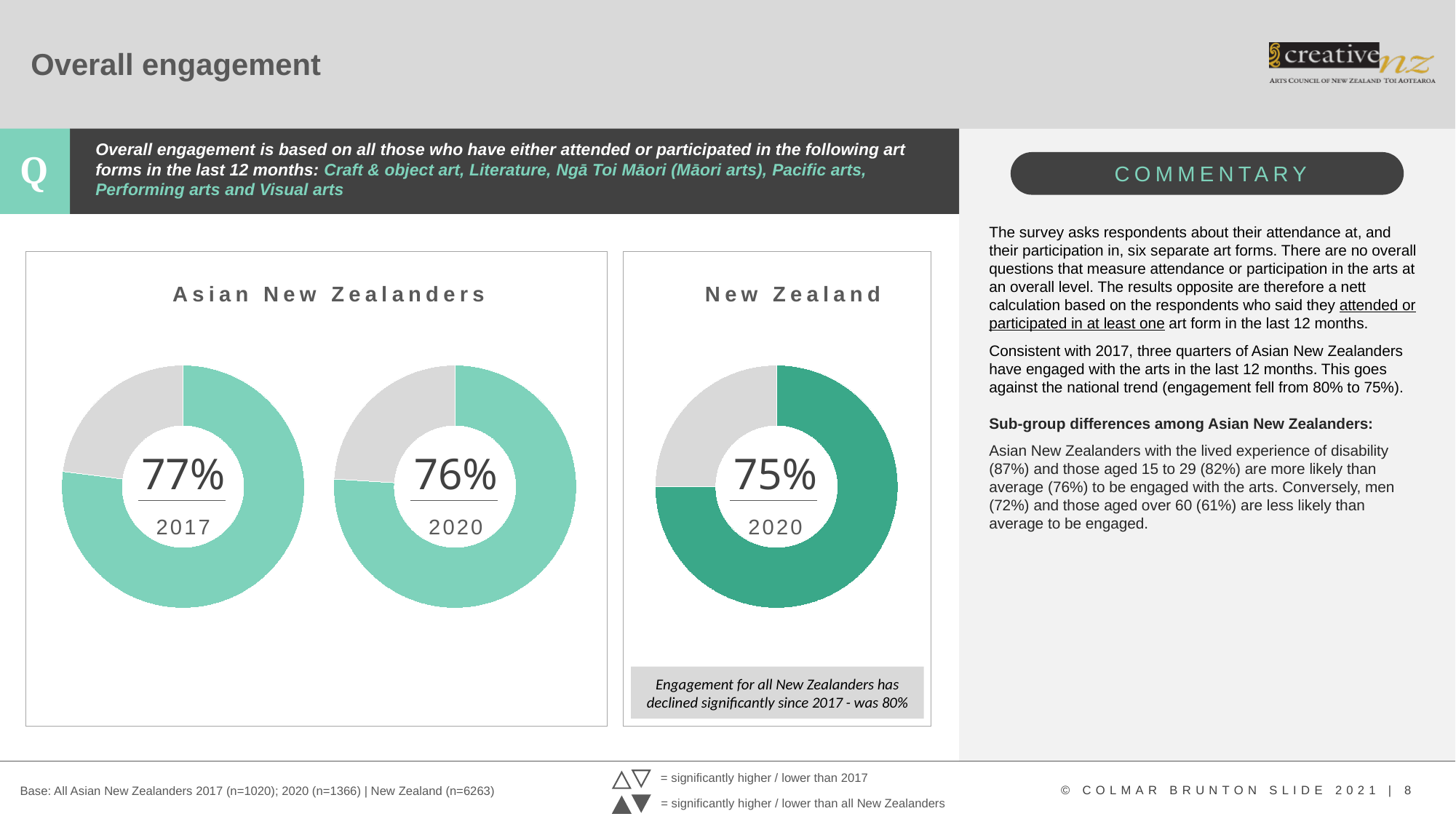
In the Asian New Zealanders chart, what is the overall engagement value shown for 2017? 77% How many donut charts are shown in the Asian New Zealanders panel? 2 In the New Zealand chart, what is the overall engagement value shown for 2020? 75% What kind of chart is used to show the engagement values on this slide? Donut (pie) chart According to the note under the New Zealand chart, what was engagement for all New Zealanders in 2017? 80% In the Asian New Zealanders chart, what is the overall engagement value shown for 2020? 76% Which is larger: the 2020 engagement for Asian New Zealanders or the 2020 engagement for New Zealand? Asian New Zealanders (76%) In the Asian New Zealanders chart, did engagement rise or fall from 2017 to 2020? Fall In the Asian New Zealanders chart, by how many percentage points did engagement change between 2017 and 2020? 1 percentage point In the New Zealand chart, by how many percentage points did engagement decline from 2017 (as stated in the note) to 2020? 5 percentage points Across all three donut charts on the slide, which shows the highest engagement value? Asian New Zealanders 2017 (77%) In the New Zealand 2020 donut chart, what share is represented by the grey (non-engaged) portion? 25%